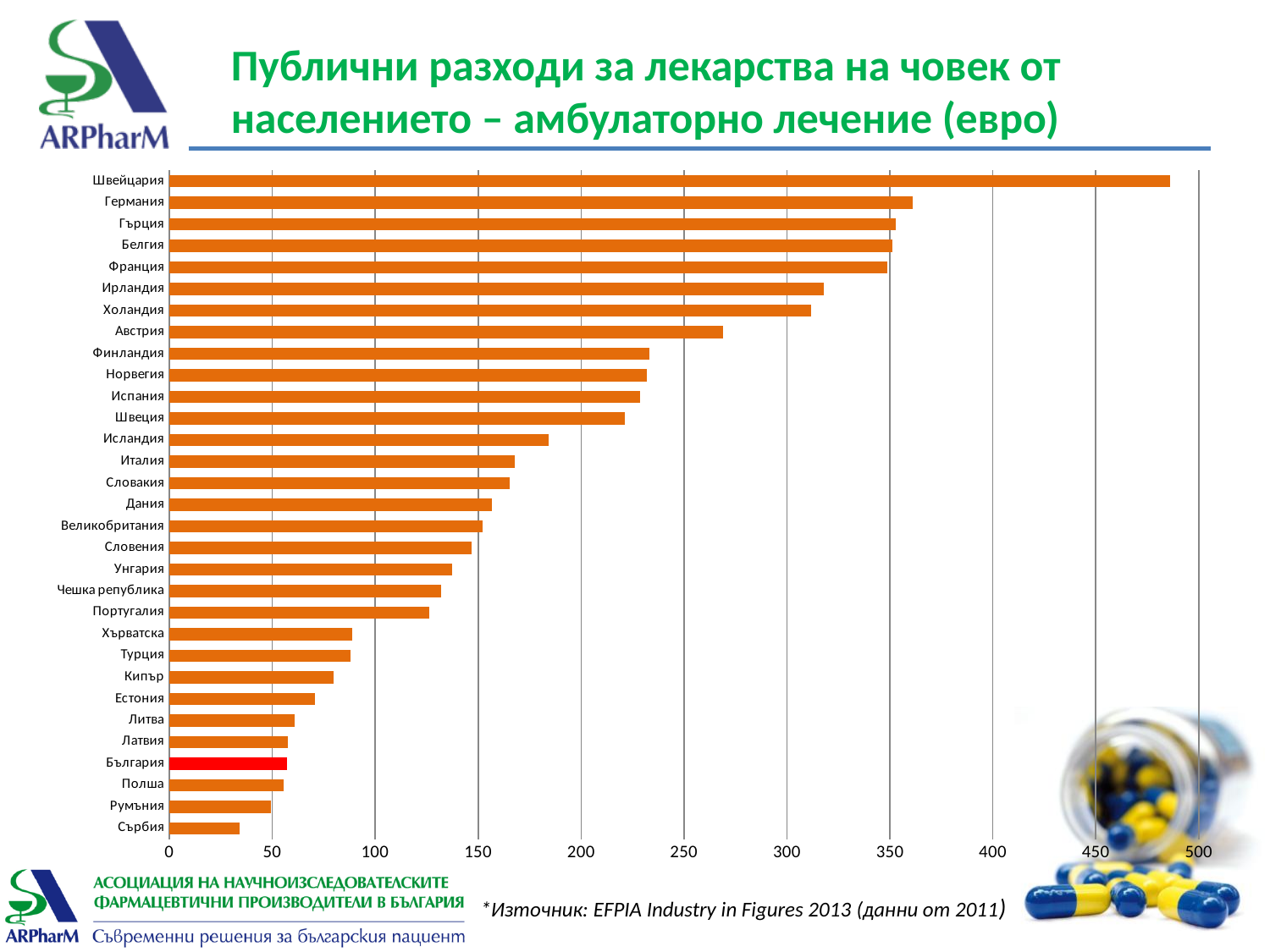
Do the bar values increase or decrease going from the top of the chart to the bottom? decrease Which country has the lowest value in the chart? Сърбия Is the value for Исландия greater or less than 200? less Is the value for Германия greater or less than 350? greater Which country's bar is highlighted in red? България Which has a larger value, Австрия or Финландия? Австрия What kind of chart is shown on the slide? bar chart How many countries are listed in the chart? 31 Is the value for Швейцария greater or less than 450? greater Which country has the highest public spending on medicines per capita in the chart? Швейцария